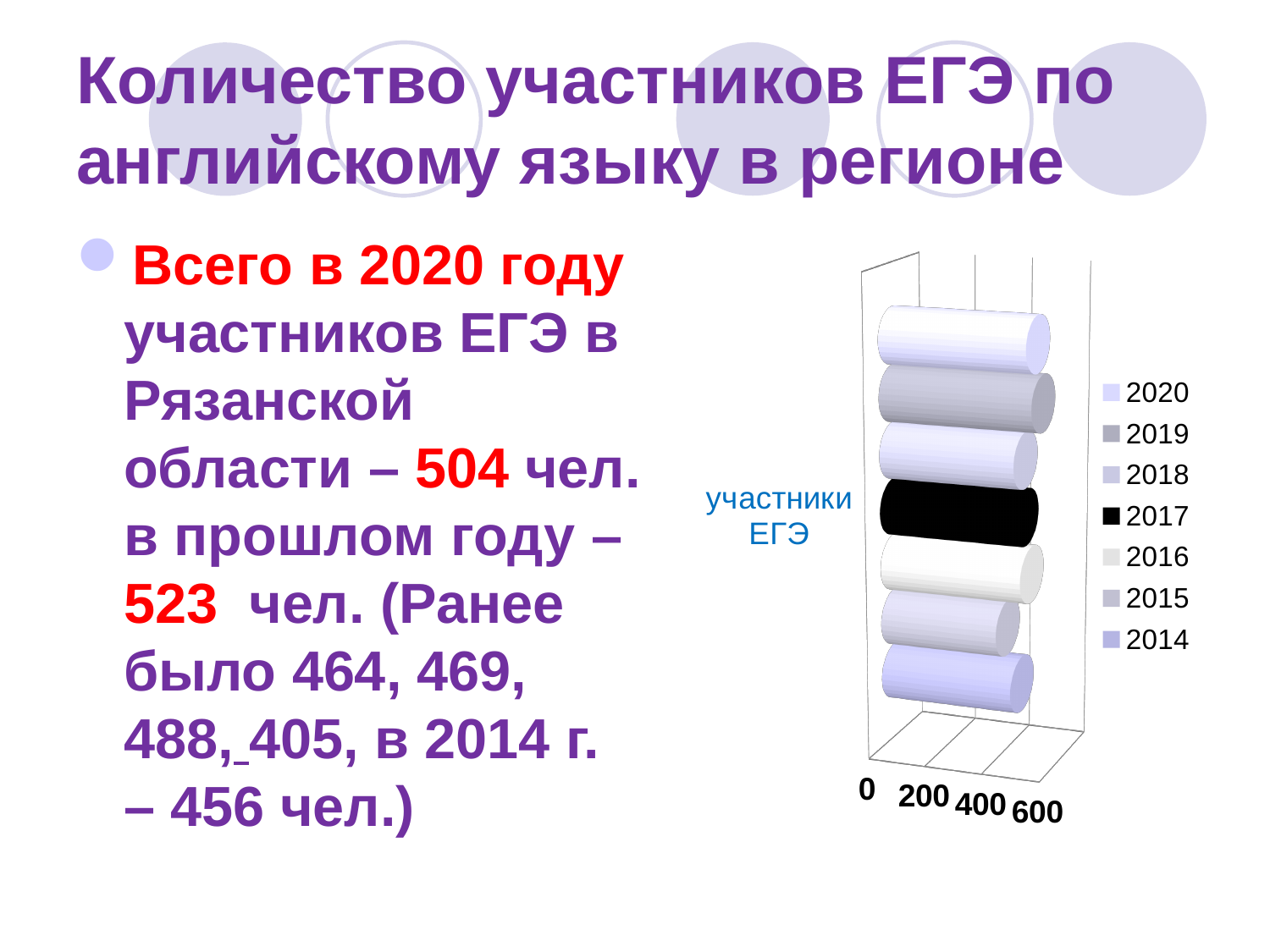
How many series does the chart legend list? 7 Is the value for 2020 greater or less than 600? less What is the difference between the number of participants in 2019 and in 2020? 19 What is the label of the single category on the chart? участники ЕГЭ What kind of chart is shown on the slide? bar chart Which years are listed in the chart legend? 2020, 2019, 2018, 2017, 2016, 2015, 2014 Is the value for 2019 greater or less than 400? greater Is the value for 2014 greater or less than 200? greater Which is larger, the number of participants in 2019 or in 2020? 2019 According to the slide, how many ЕГЭ participants were there in 2019? 523 According to the slide, how many ЕГЭ participants were there in 2020? 504 How many categories are plotted on the chart's category axis? 1